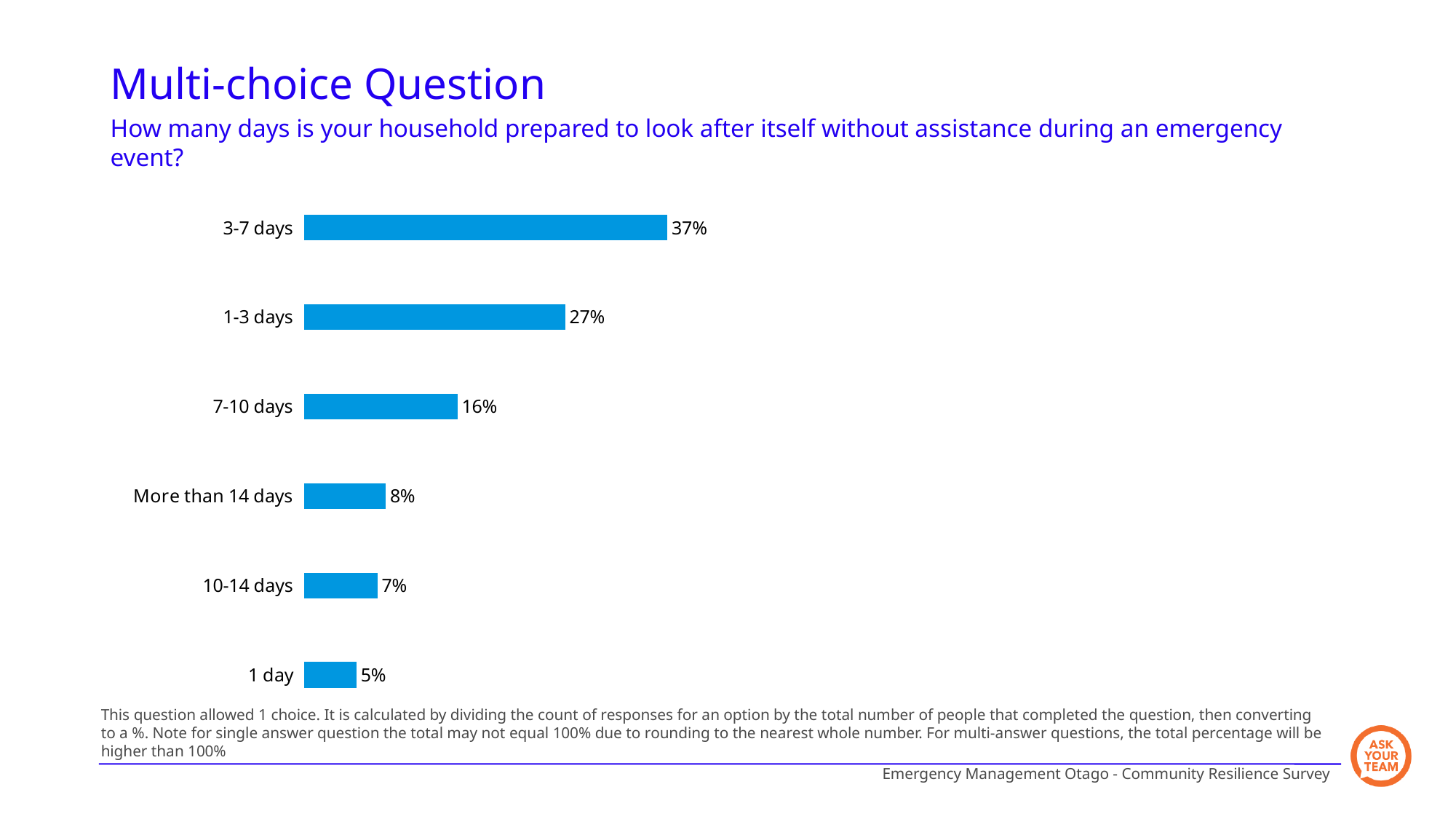
Which category has the lowest percentage? 1 day How many categories are shown in the chart? 6 Which category has the highest percentage? 3-7 days What percentage of respondents selected 1 day? 5% What percentage is shown for 7-10 days? 16% What is the value for the 'More than 14 days' category? 8% Which has a higher value: 10-14 days or More than 14 days? More than 14 days What is the value shown for the 1-3 days category? 27% What percentage of respondents said their household is prepared for 3-7 days? 37% What is the difference in percentage points between 3-7 days and 1-3 days? 10 What type of chart is shown on the slide? Bar chart What is the difference in percentage points between 7-10 days and 10-14 days? 9